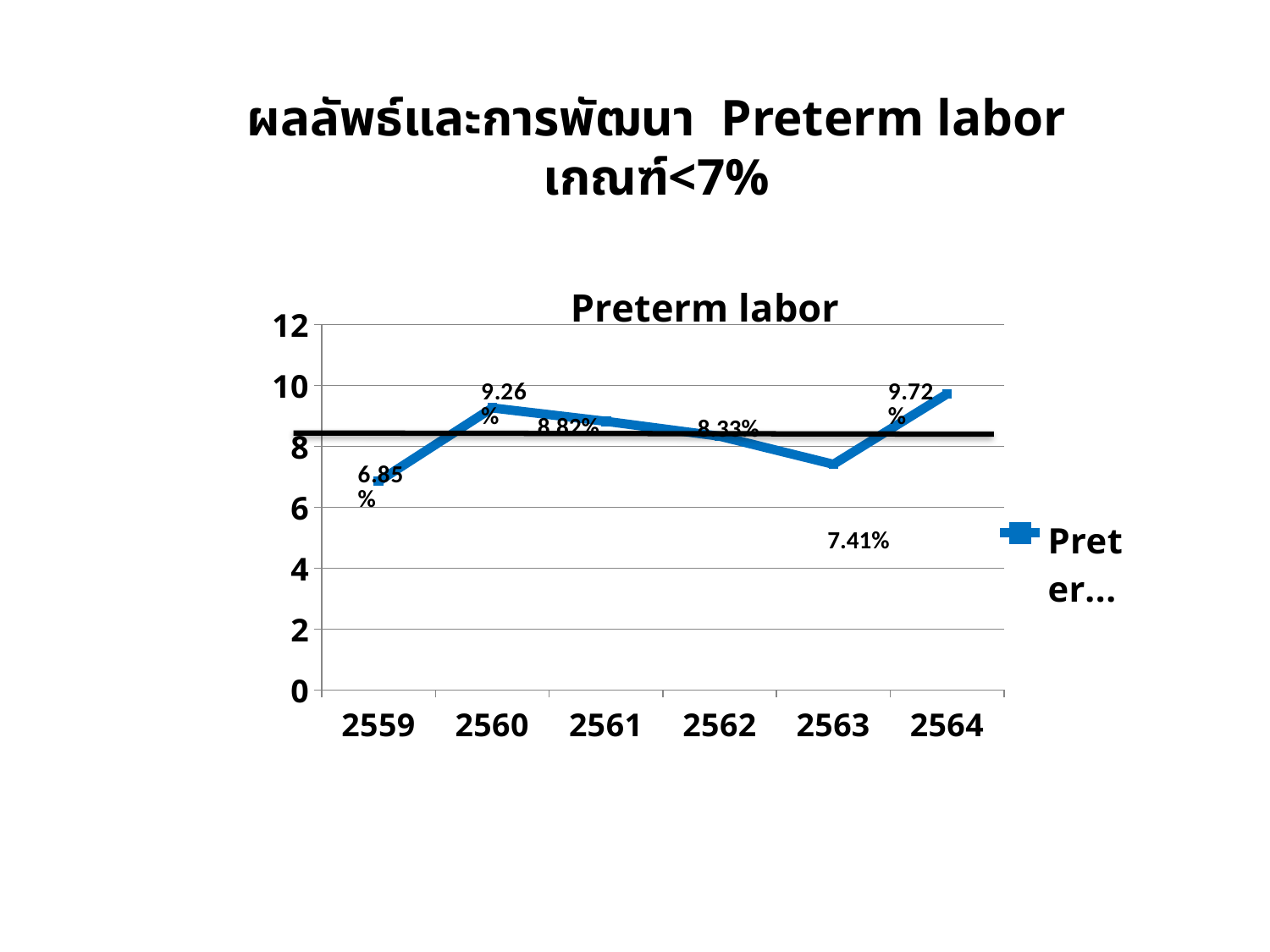
What is the value for 2564? 9.72% What is the difference between the values for 2564 and 2559? 2.87% Which year has the highest value? 2564 Is the value for 2560 greater or less than 8? greater What is the chart's title? Preterm labor What is the value for 2560? 9.26% How many years are plotted on the x axis? 6 What is the value for 2563? 7.41% What type of chart is shown on the slide? line chart Which year has the lowest value? 2559 Which is larger, the value for 2559 or the value for 2563? 2563 What is the value for 2559? 6.85%